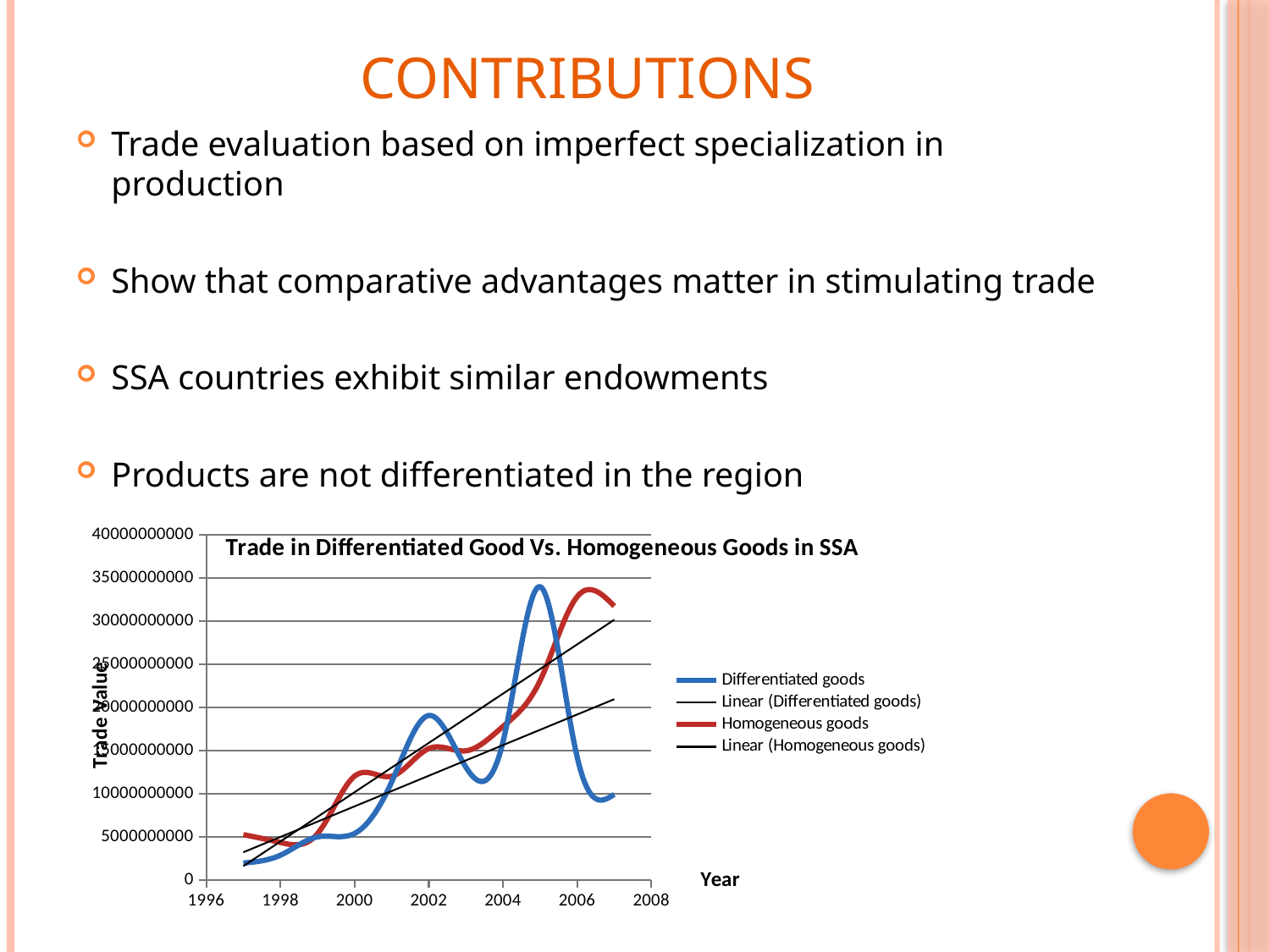
What is the title of the chart? Trade in Differentiated Good Vs. Homogeneous Goods in SSA In 2007, which series has the larger value, Differentiated goods or Homogeneous goods? Homogeneous goods Is the value for Homogeneous goods in 2007 greater or less than 30000000000? greater Is the value for Homogeneous goods in 2000 greater or less than 10000000000? greater How many entries does the chart's legend list? 4 Does the Homogeneous goods series generally rise or fall from 1997 to 2007? rise What kind of chart is shown on the slide? line chart Is the value for Differentiated goods in 2002 greater or less than 15000000000? greater In 2005, which series has the larger value, Differentiated goods or Homogeneous goods? Differentiated goods What colour is the Differentiated goods line in the chart? blue